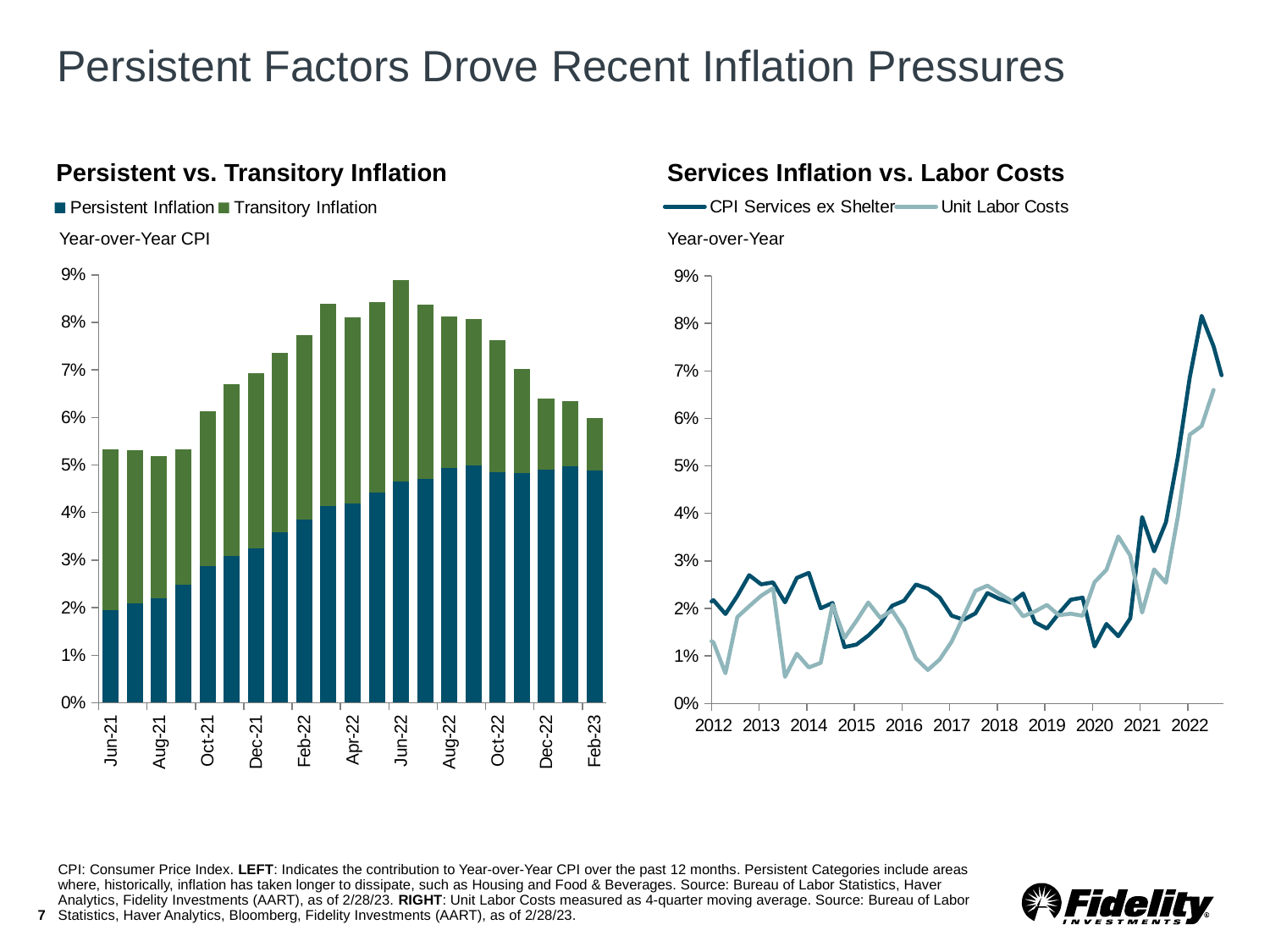
What kind of chart is the right chart, 'Services Inflation vs. Labor Costs'? Line chart What kind of chart is the left chart, 'Persistent vs. Transitory Inflation'? Stacked bar chart In the right chart, which series reaches a higher peak in 2022, CPI Services ex Shelter or Unit Labor Costs? CPI Services ex Shelter In the left chart, is the Persistent Inflation value for Jun-22 greater or less than 4%? greater In the left chart, which month has the tallest stacked bar? Jun-22 In the left chart, is the total bar height for Jun-22 greater or less than 8%? greater How many series does the legend of the right chart list? 2 How many series does the legend of the left chart list? 2 In the right chart, do both series rise or fall from 2020 to 2022? Rise In the left chart, how many monthly bars are plotted? 21 In the left chart, is the total bar height for Jun-21 greater or less than 5%? greater